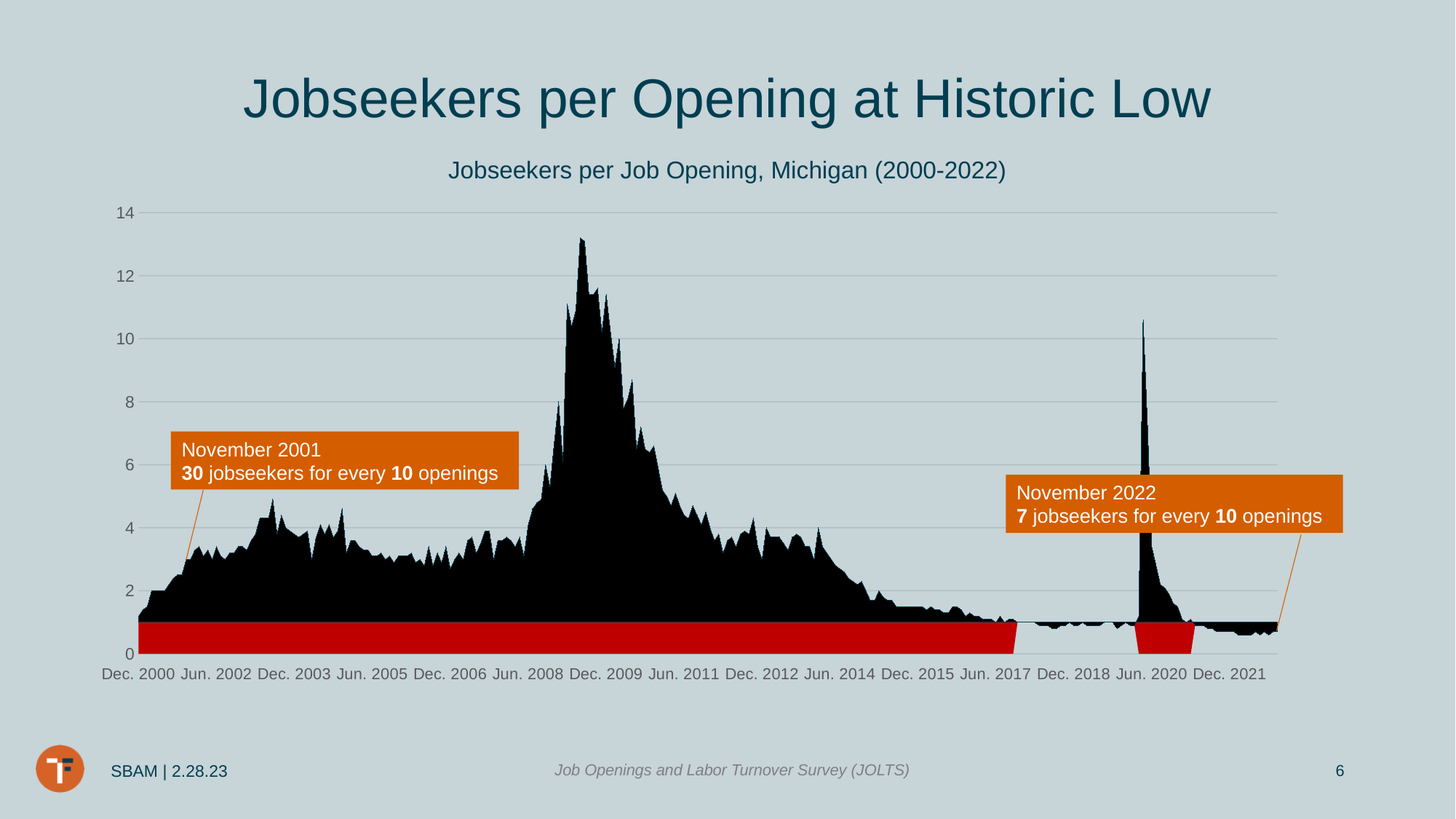
Is the peak value of the chart around Dec. 2009 greater or less than 12? greater Which is larger: the value around Dec. 2009 or the value around Jun. 2020? Dec. 2009 Is the value at the spike around Jun. 2020 greater or less than 8? greater What kind of chart is shown on the slide? area chart Between Dec. 2009 and Dec. 2015, do the values generally rise or fall? fall According to the annotation, how many jobseekers were there for every 10 openings in November 2001? 30 What is the highest value shown on the y axis? 14 Around which x-axis label does the chart reach its highest value? Dec. 2009 What is the title of the chart? Jobseekers per Job Opening, Michigan (2000-2022) Is the value at Dec. 2015 greater or less than 2? less According to the annotation, how many jobseekers were there for every 10 openings in November 2022? 7